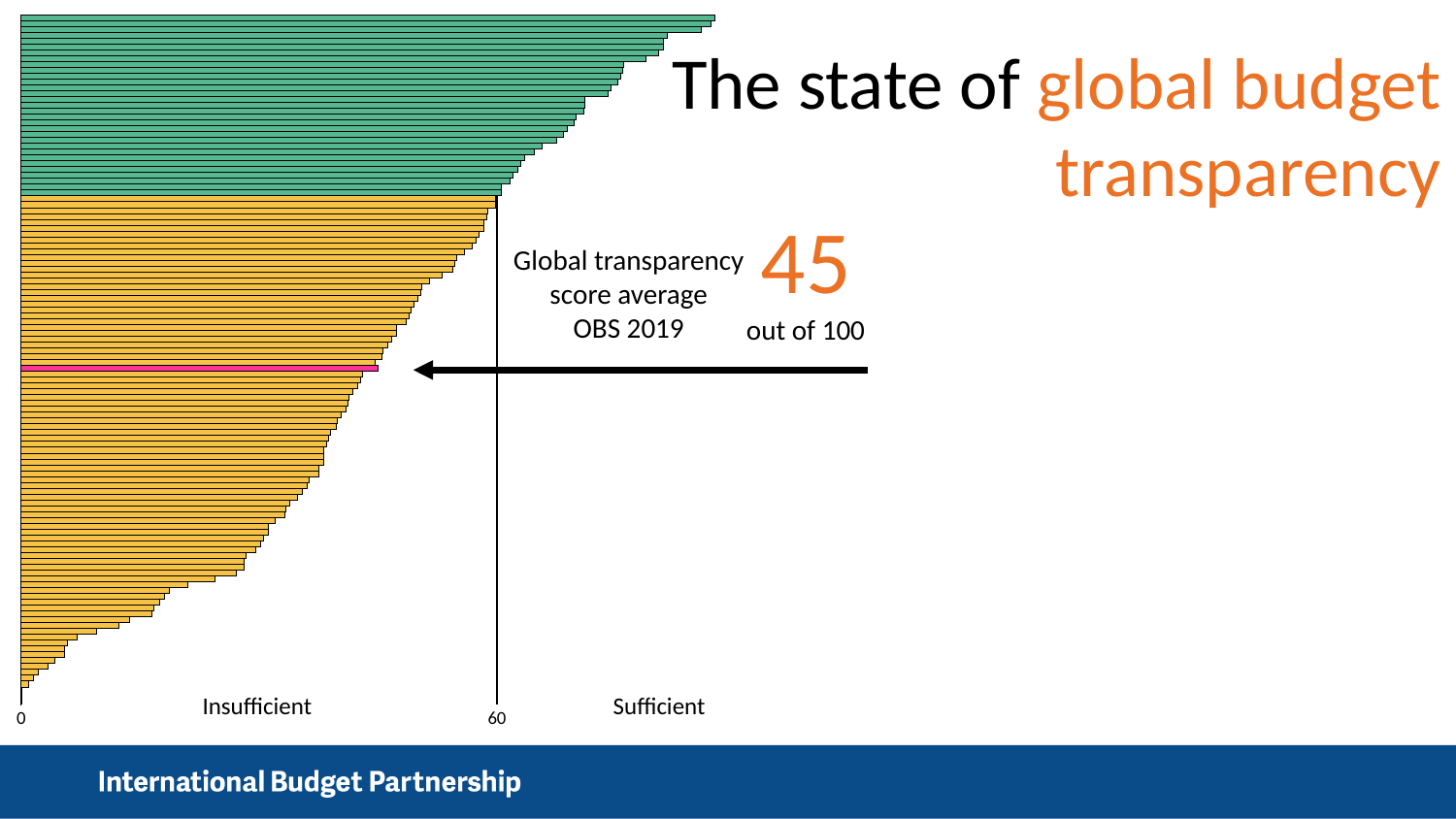
Do the bar lengths increase or decrease going from the top of the chart to the bottom? decrease What is the global transparency score average for OBS 2019 shown on the slide? 45 What is the difference between the 'Sufficient' threshold of 60 and the global transparency score average of 45? 15 Is the global transparency score average (the magenta bar) greater or less than 60? less Out of what maximum score is the global transparency score average of 45 given? 100 Which region of the chart is labelled to the right of the 60 line: 'Insufficient' or 'Sufficient'? Sufficient What kind of chart is shown on the slide? bar chart Which is larger: the global transparency score average of 45 or the 'Sufficient' threshold of 60? 60 Is the shortest bar at the bottom of the chart greater or less than 60? less What colour are the bars that extend beyond the 60 line? green Is the longest bar at the top of the chart greater or less than 60? greater What value on the x axis marks the boundary between the 'Insufficient' and 'Sufficient' regions? 60